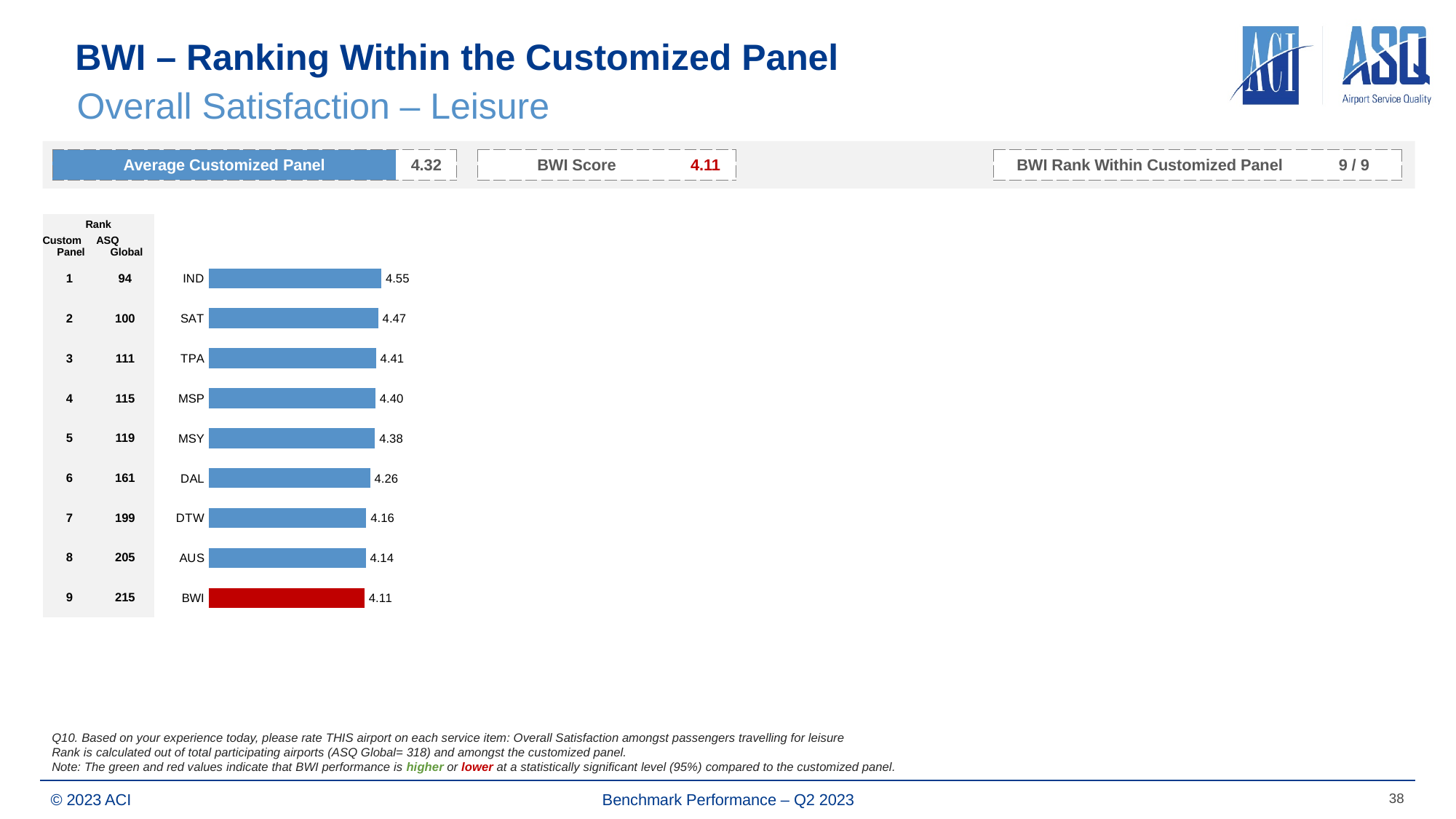
Which bar is coloured red? BWI What is the value for IND? 4.55 What is the value for DAL? 4.26 Which airport has the lowest value? BWI Which is larger, the value for TPA or the value for DTW? TPA What is the value for BWI? 4.11 What kind of chart is shown? bar chart Do the values rise or fall going down the chart from IND to BWI? fall Which airport has the highest value? IND How many airports are shown in the chart? 9 What is the difference between the values for SAT and AUS? 0.33 What is the difference between the values for IND and BWI? 0.44